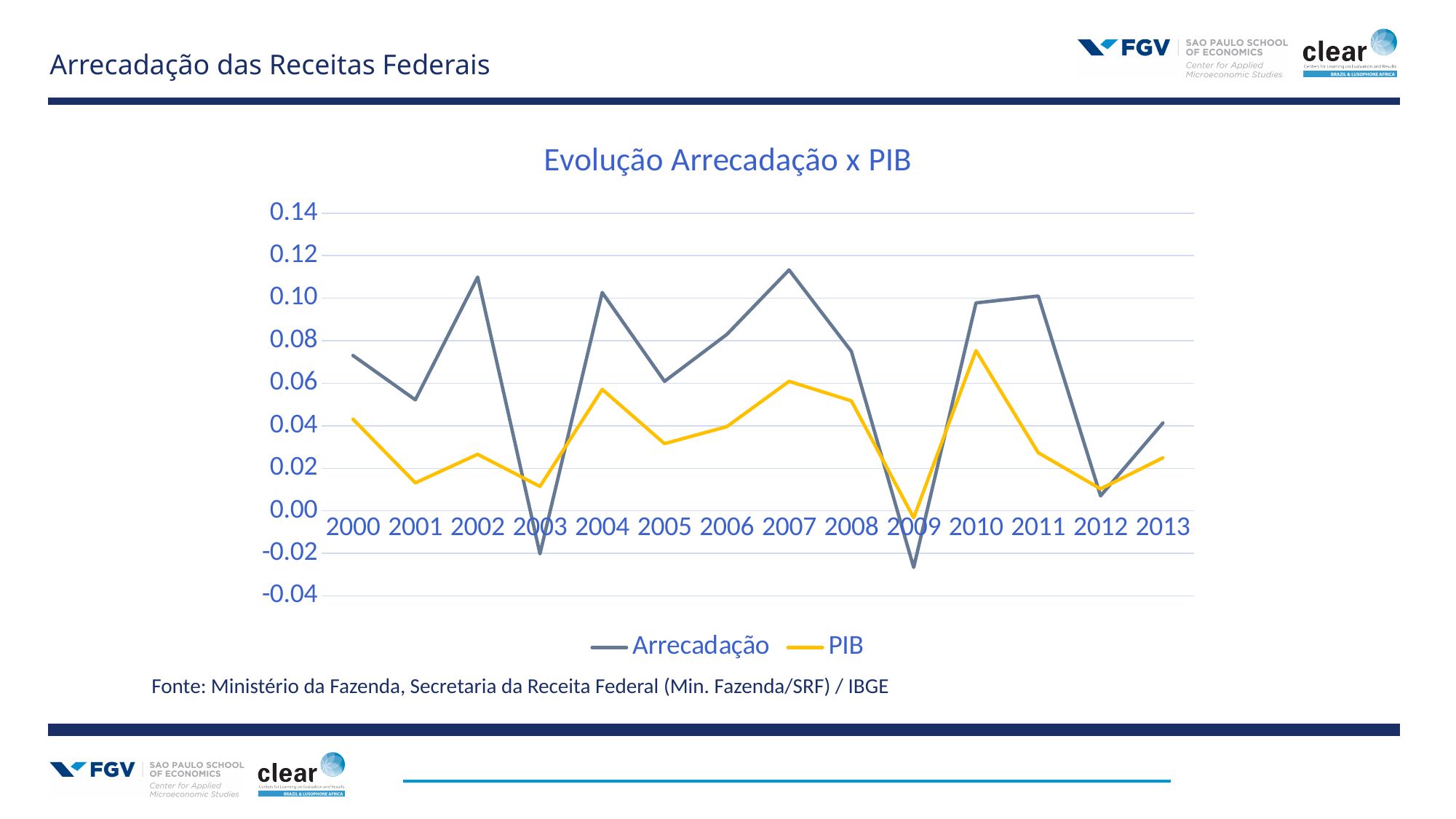
Is the PIB value for 2001 greater or less than 0.02? less What kind of chart is shown on the slide? line chart In which year is the Arrecadação series at its lowest? 2009 What is the title of the chart? Evolução Arrecadação x PIB Is the Arrecadação value for 2003 greater or less than 0.00? less In 2003, which series has the larger value, Arrecadação or PIB? PIB In which year is the PIB series at its highest? 2010 In which year is the PIB series at its lowest? 2009 How many years are plotted along the x axis? 14 How many series does the legend list? 2 Which series is drawn in yellow? PIB Is the Arrecadação value for 2007 greater or less than 0.10? greater